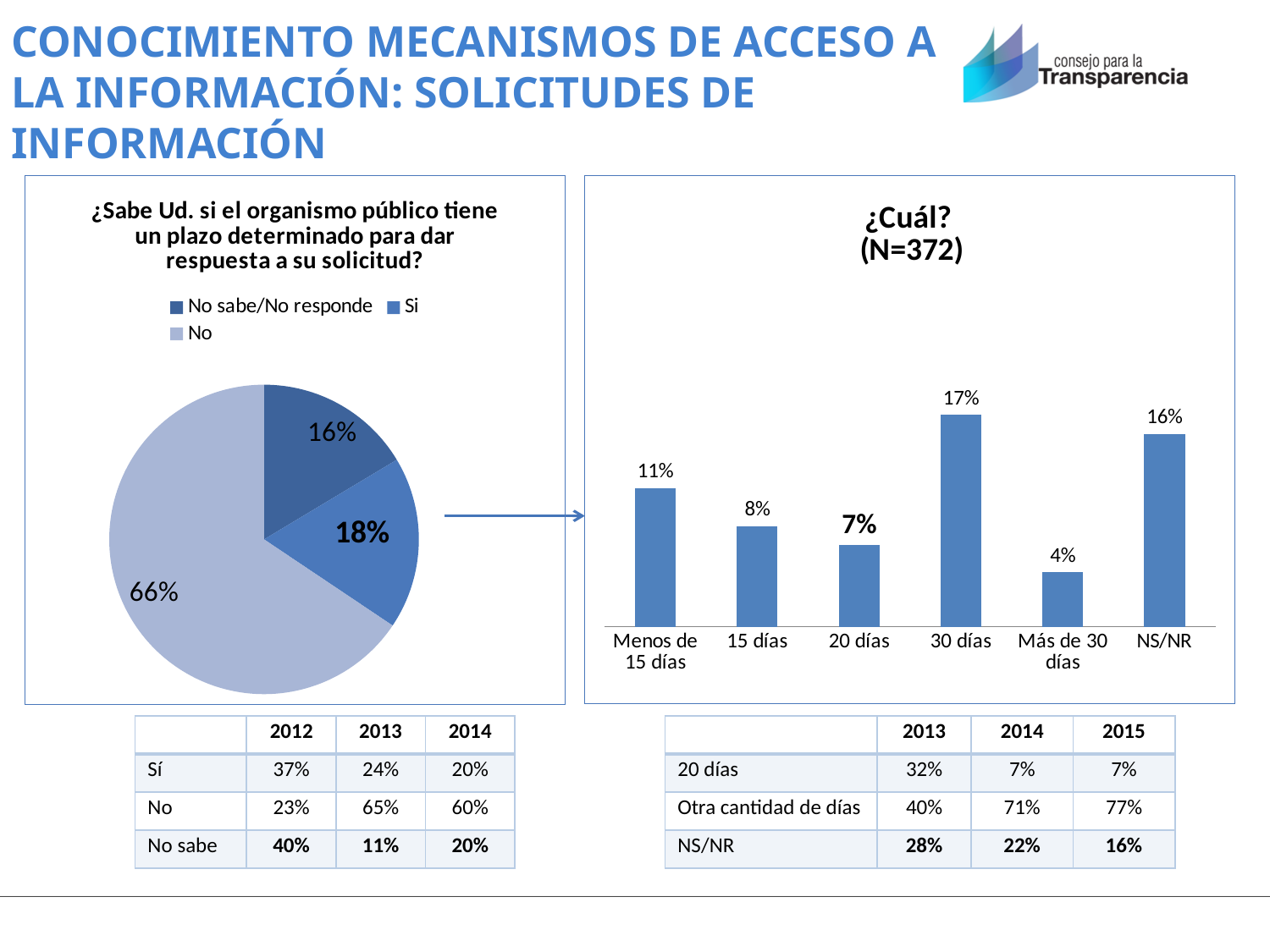
How many categories are shown in the bar chart titled "¿Cuál? (N=372)"? 6 In the bar chart titled "¿Cuál? (N=372)", what is the difference between the values for "30 días" and "Más de 30 días"? 13% In the pie chart on the left of the slide, what is the value for "Si"? 18% In the bar chart titled "¿Cuál? (N=372)", which category has the highest value? 30 días In the bar chart titled "¿Cuál? (N=372)", what is the value for "30 días"? 17% In the bar chart titled "¿Cuál? (N=372)", what is the value for "Menos de 15 días"? 11% How many entries does the legend of the pie chart on the left of the slide list? 3 In the bar chart titled "¿Cuál? (N=372)", which is larger, the value for "15 días" or the value for "NS/NR"? NS/NR In the pie chart on the left of the slide, what share does the "No" slice have? 66% In the bar chart titled "¿Cuál? (N=372)", which category has the lowest value? Más de 30 días In the pie chart on the left of the slide, which slice is the smallest? No sabe/No responde What kind of chart is the chart on the right of the slide, titled "¿Cuál? (N=372)"? Bar chart